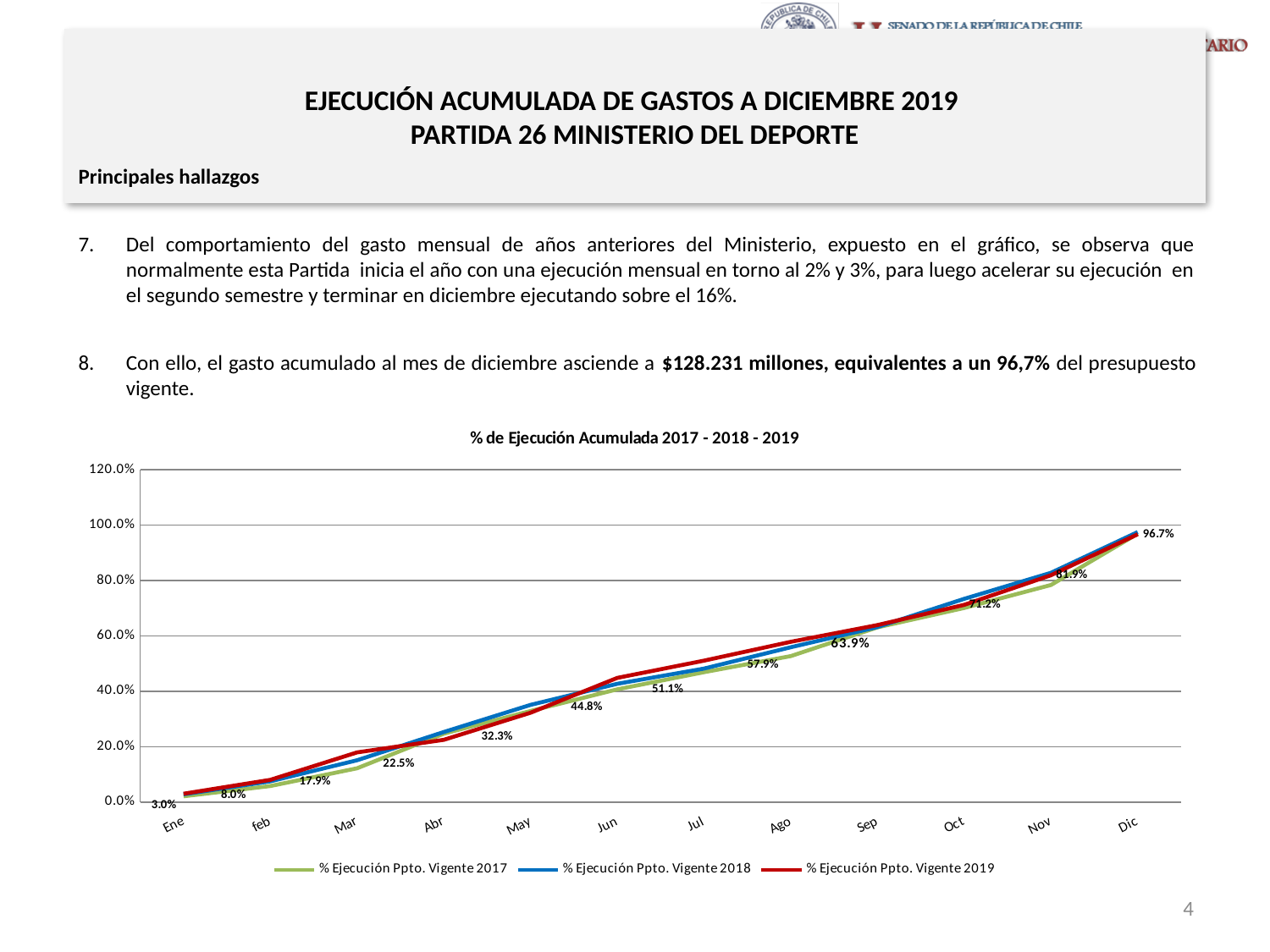
Do the values in the chart rise or fall from Ene to Dic? rise How many months are shown on the x axis of the chart? 12 How many series does the legend list in the chart '% de Ejecución Acumulada 2017 - 2018 - 2019'? 3 What is the labelled value for Sep in the '% Ejecución Ppto. Vigente 2019' series? 63.9% What is the labelled value for Jun in the '% Ejecución Ppto. Vigente 2019' series? 44.8% What is the labelled value for Dic in the '% Ejecución Ppto. Vigente 2019' series? 96.7% Which month has the highest labelled value in the '% Ejecución Ppto. Vigente 2019' series? Dic What is the labelled value for Ene in the '% Ejecución Ppto. Vigente 2019' series? 3.0% What type of chart is shown on the slide? line chart Which month has the lowest labelled value in the '% Ejecución Ppto. Vigente 2019' series? Ene What is the difference between the labelled values for Nov and Oct in the '% Ejecución Ppto. Vigente 2019' series? 10.7% Is the value for Abr in the '% Ejecución Ppto. Vigente 2017' series greater or less than 40.0%? less